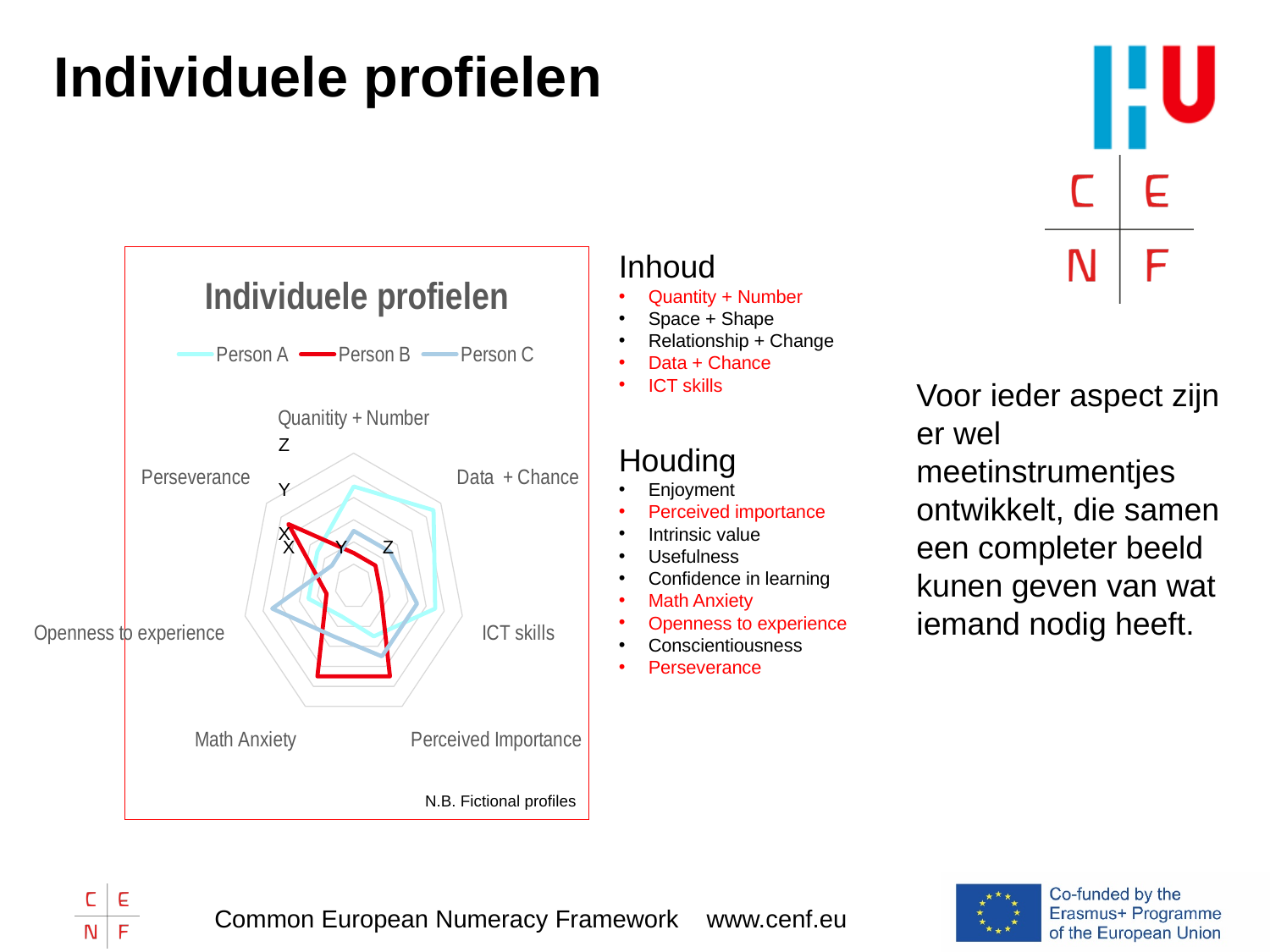
Which series is drawn in red on the chart? Person B What kind of chart is shown on the slide? Radar chart For Data + Chance, which is larger: the value for Person A or the value for Person C? Person A How many categories (axes) does the radar chart have? 7 For Math Anxiety, which is larger: the value for Person A or the value for Person B? Person B For Openness to experience, which is larger: the value for Person C or the value for Person A? Person C Which person has the highest value for Openness to experience? Person C How many series does the legend of the chart list? 3 Which person has the highest value for Data + Chance? Person A What is the title of the chart? Individuele profielen Which person has the highest value for Math Anxiety? Person B